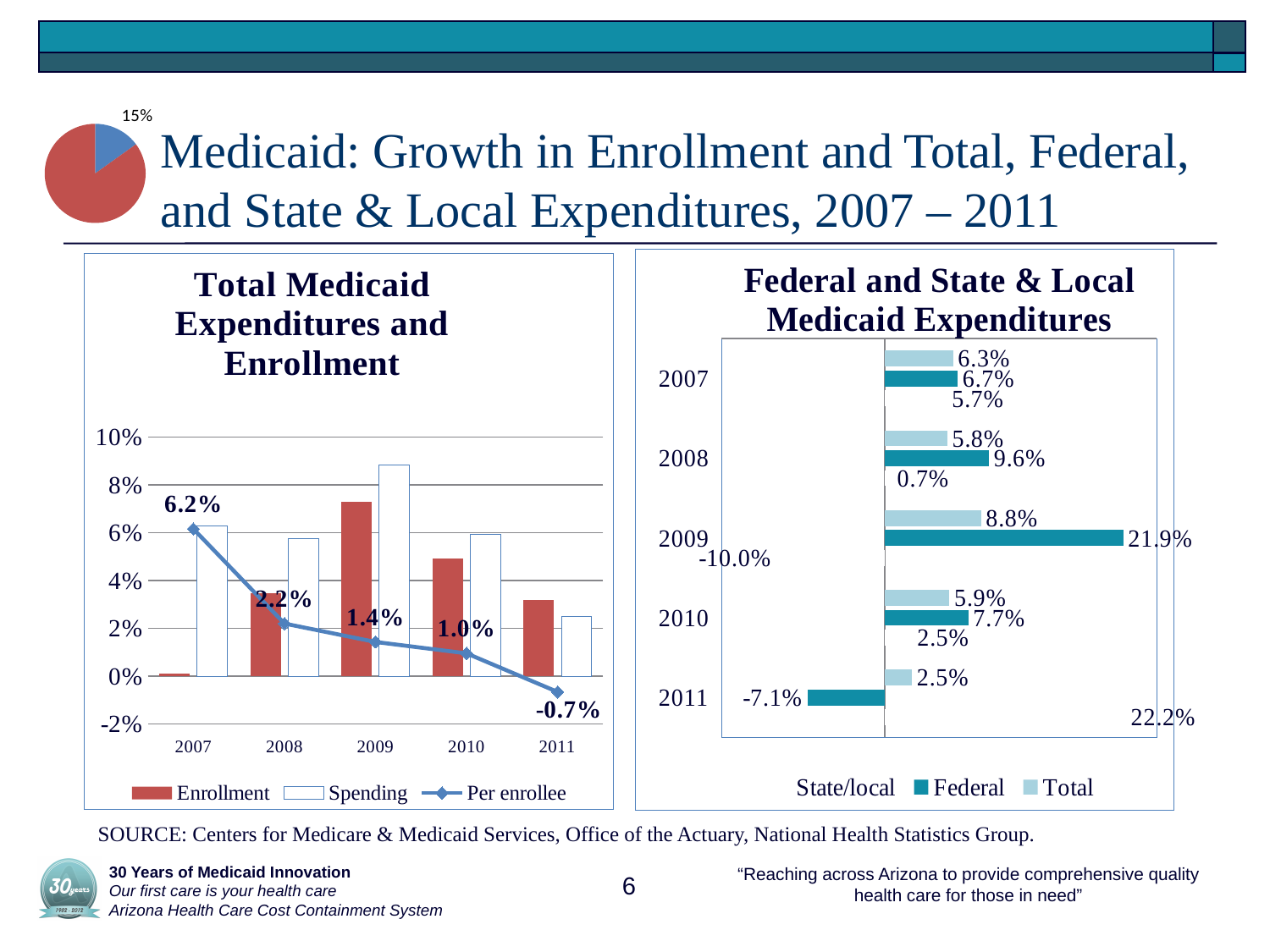
What kind of chart is the 'Federal and State & Local Medicaid Expenditures' chart? bar chart In the 'Total Medicaid Expenditures and Enrollment' chart, is the Spending value for 2009 greater or less than 8%? greater In the 'Total Medicaid Expenditures and Enrollment' chart, what is the Per enrollee value for 2007? 6.2% In the 'Total Medicaid Expenditures and Enrollment' chart, what is the Per enrollee value for 2011? -0.7% How many series does the legend of the 'Total Medicaid Expenditures and Enrollment' chart list? 3 In the 'Federal and State & Local Medicaid Expenditures' chart, which year has the highest Federal value? 2009 In the 'Federal and State & Local Medicaid Expenditures' chart, which is larger for 2008, the Federal value or the Total value? Federal In the 'Total Medicaid Expenditures and Enrollment' chart, does the Per enrollee line rise or fall from 2007 to 2011? fall In the 'Federal and State & Local Medicaid Expenditures' chart, what is the Federal value for 2009? 21.9% In the 'Federal and State & Local Medicaid Expenditures' chart, which year has the lowest Federal value? 2011 In the 'Total Medicaid Expenditures and Enrollment' chart, what is the difference between the Per enrollee values for 2007 and 2008? 4.0 percentage points In the 'Federal and State & Local Medicaid Expenditures' chart, what is the State/local value for 2011? 22.2%